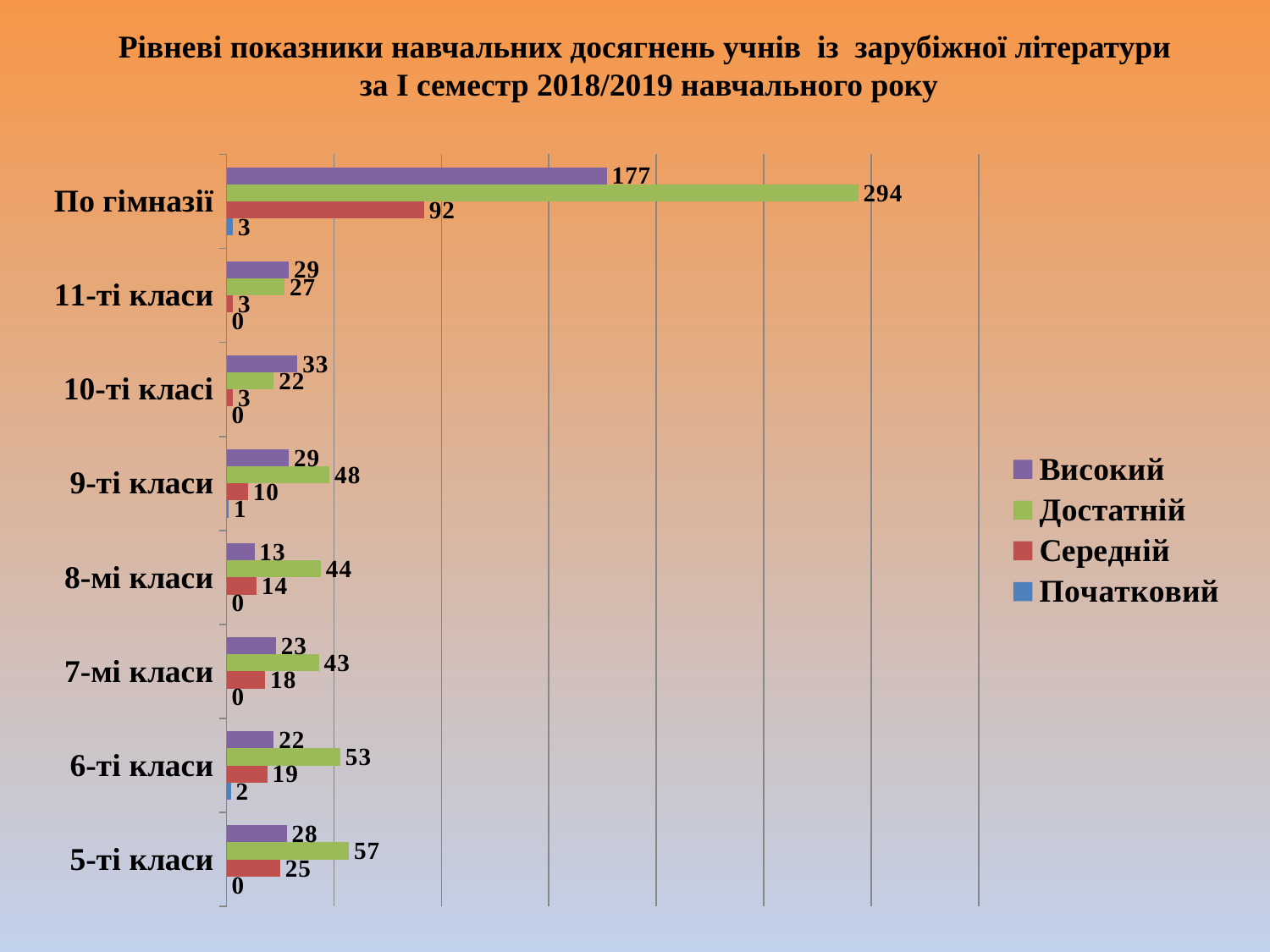
What is the value of Високий for 10-ті класі? 33 What is the value of Достатній for По гімназії? 294 Which is larger for 11-ті класи: Високий or Достатній? Високий What kind of chart is shown on the slide? bar chart How many categories are shown on the chart? 8 Among the class categories (excluding По гімназії), which has the lowest Високий value? 8-мі класи What is the value of Початковий for 6-ті класи? 2 Which series is shown in green in the legend? Достатній Among the class categories (excluding По гімназії), which has the highest Достатній value? 5-ті класи How many series does the legend list? 4 What is the difference between the Високий and Середній values for По гімназії? 85 What is the value of Середній for 5-ті класи? 25